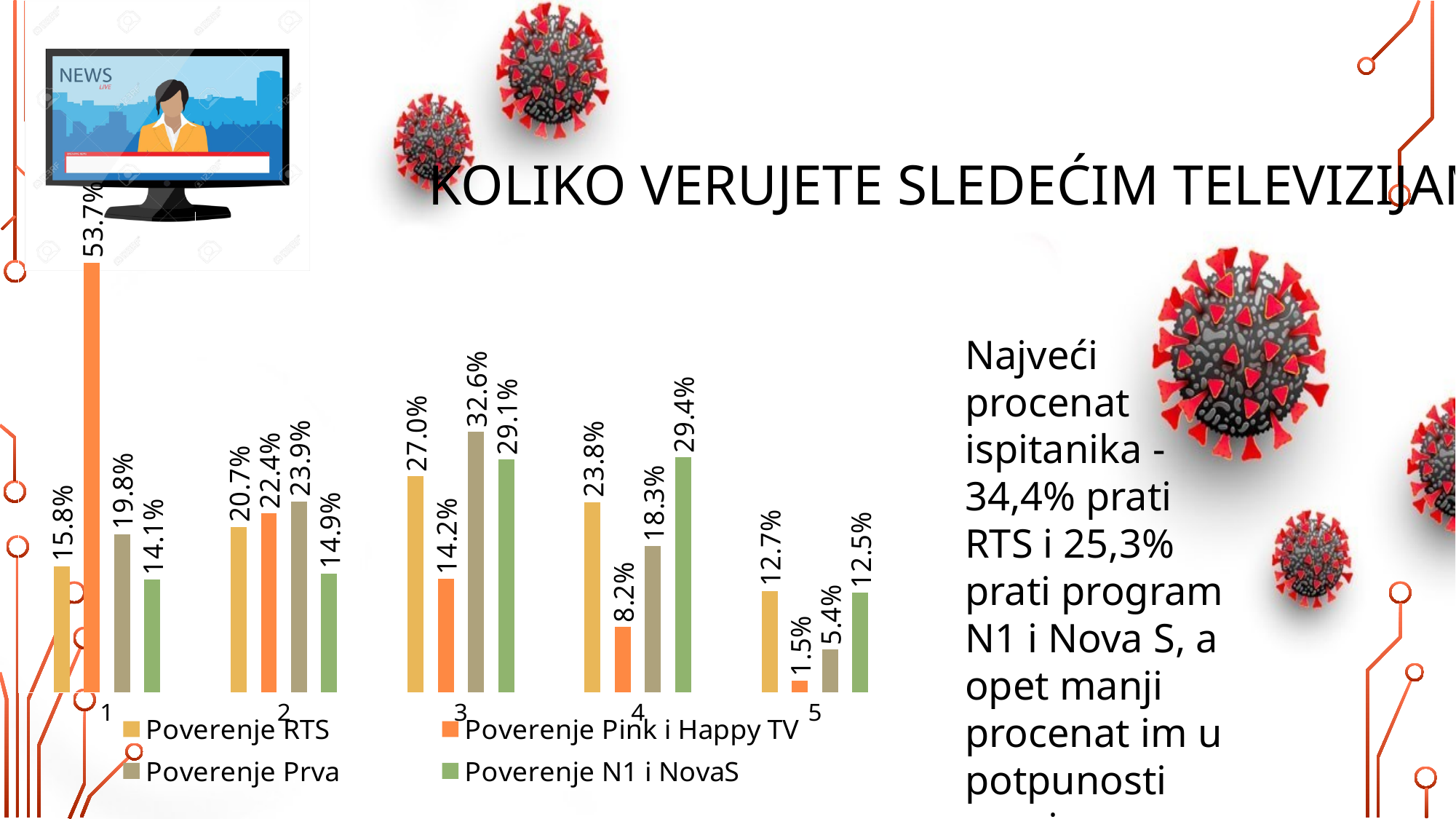
What is the difference between Poverenje Prva and Poverenje RTS at category 3? 5.6% Which category has the lowest value for Poverenje Pink i Happy TV? 5 What is the value for Poverenje RTS at category 5? 12.7% What is the value for Poverenje N1 i NovaS at category 4? 29.4% Which category has the highest value for Poverenje RTS? 3 What kind of chart is shown on the slide? Bar chart Which series is shown in green in the legend? Poverenje N1 i NovaS How many series does the legend list? 4 What is the value for Poverenje Pink i Happy TV at category 1? 53.7% How many categories are shown on the x axis? 5 What is the value for Poverenje Prva at category 3? 32.6% At category 4, which is larger: Poverenje RTS or Poverenje Prva? Poverenje RTS